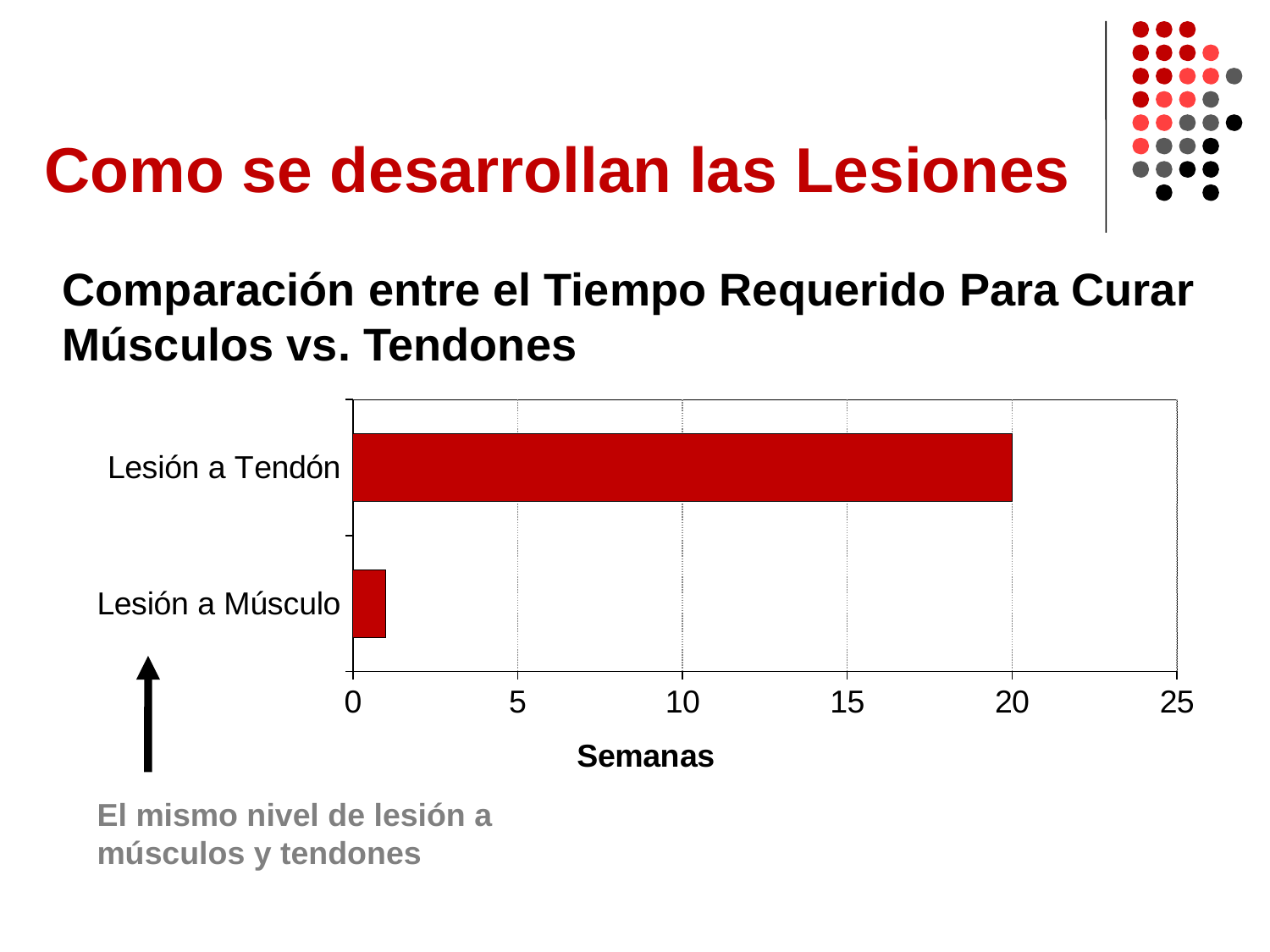
Which is larger, the value for Lesión a Tendón or the value for Lesión a Músculo? Lesión a Tendón What kind of chart is shown on the slide? bar chart How many categories are plotted in the chart? 2 Is the value for Lesión a Músculo greater or less than 5? less What is the title of the chart? Comparación entre el Tiempo Requerido Para Curar Músculos vs. Tendones Is the value for Lesión a Tendón greater or less than 15? greater What is the label of the horizontal axis of the chart? Semanas Is the value for Lesión a Tendón greater or less than 25? less Which category has the lowest value in the chart? Lesión a Músculo How many weeks (Semanas) does the bar for Lesión a Tendón reach? 20 Which category has the highest value in the chart? Lesión a Tendón